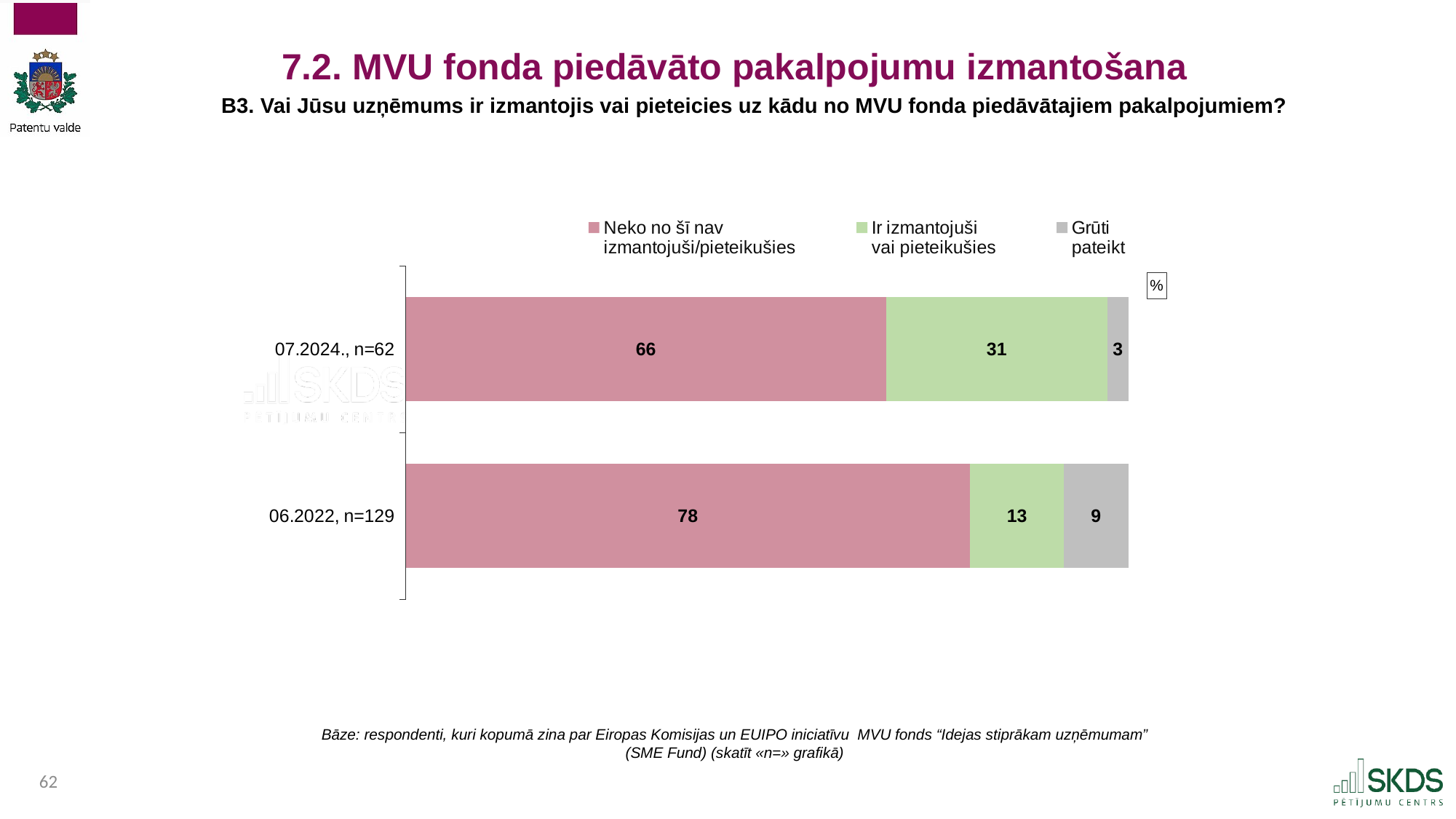
Which legend entry is shown in green? Ir izmantojuši vai pieteikušies What is the total of the 07.2024., n=62 stacked bar? 100 What kind of chart is shown on the slide? Stacked bar chart What is the value for "Neko no šī nav izmantojuši/pieteikušies" in the 07.2024., n=62 bar? 66 What is the difference between the "Ir izmantojuši vai pieteikušies" values for 07.2024., n=62 and 06.2022, n=129? 18 Which bar has the higher value for "Ir izmantojuši vai pieteikušies", 07.2024., n=62 or 06.2022, n=129? 07.2024., n=62 What is the value for "Grūti pateikt" in the 06.2022, n=129 bar? 9 How many bars (categories) are shown in the chart? 2 What is the value for "Ir izmantojuši vai pieteikušies" in the 06.2022, n=129 bar? 13 What is the difference between the "Neko no šī nav izmantojuši/pieteikušies" values for 06.2022, n=129 and 07.2024., n=62? 12 What is the value for "Grūti pateikt" in the 07.2024., n=62 bar? 3 How many series does the legend list? 3